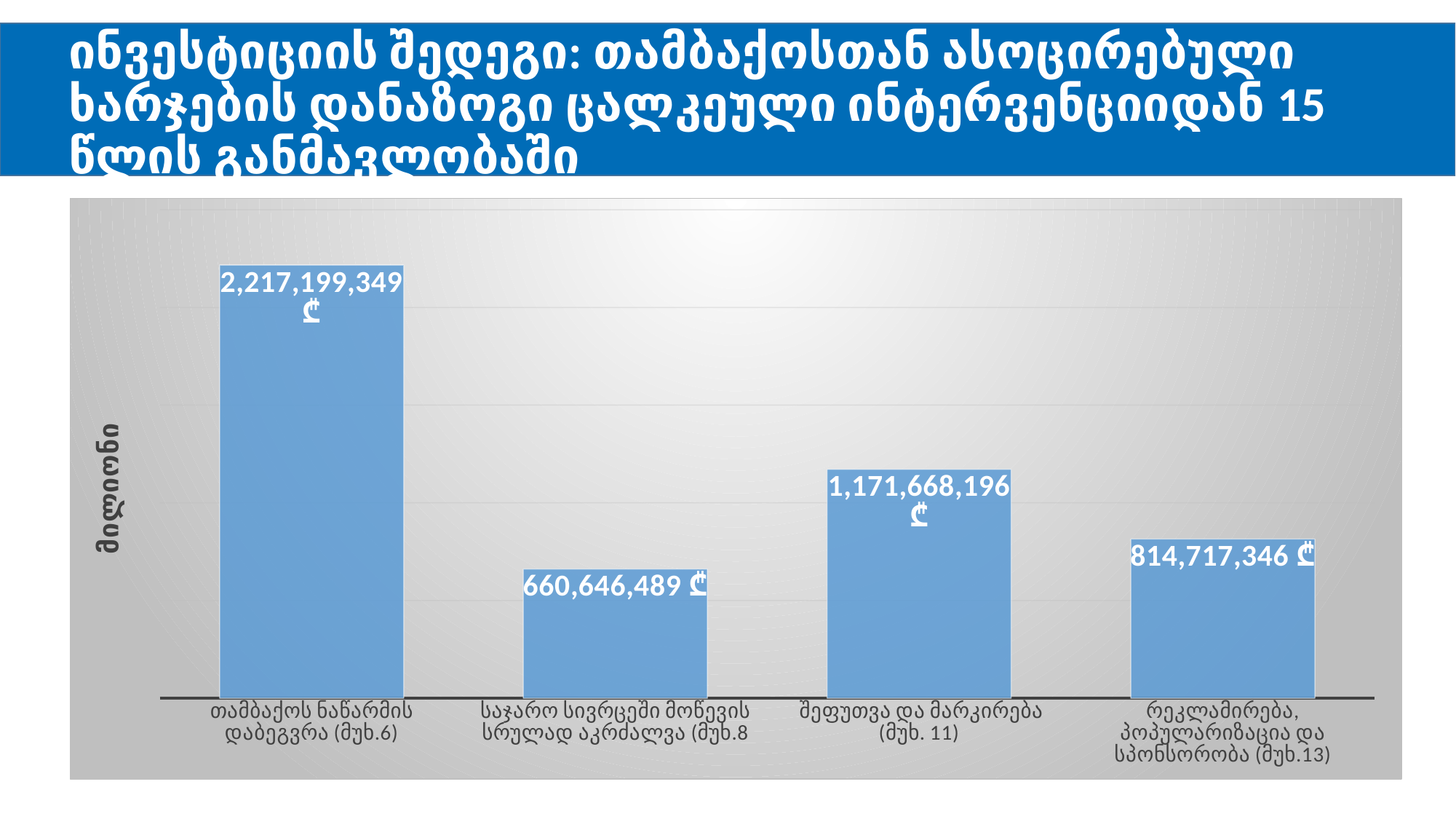
What is the value shown for საჯარო სივრცეში მოწევის სრულად აკრძალვა (მუხ.8)? 660,646,489 ₾ How many categories are shown in the chart? 4 What is the value shown for რეკლამირება, პოპულარიზაცია და სპონსორობა (მუხ.13)? 814,717,346 ₾ What is the difference between the values for შეფუთვა და მარკირება (მუხ. 11) and რეკლამირება, პოპულარიზაცია და სპონსორობა (მუხ.13)? 356,950,850 ₾ Which category has the lowest value? საჯარო სივრცეში მოწევის სრულად აკრძალვა (მუხ.8) What is the label on the vertical axis of the chart? მილიონი What is the value shown for თამბაქოს ნაწარმის დაბეგვრა (მუხ.6)? 2,217,199,349 ₾ What is the value shown for შეფუთვა და მარკირება (მუხ. 11)? 1,171,668,196 ₾ Which is larger: the value for შეფუთვა და მარკირება (მუხ. 11) or the value for რეკლამირება, პოპულარიზაცია და სპონსორობა (მუხ.13)? შეფუთვა და მარკირება (მუხ. 11) What is the difference between the values for თამბაქოს ნაწარმის დაბეგვრა (მუხ.6) and საჯარო სივრცეში მოწევის სრულად აკრძალვა (მუხ.8)? 1,556,552,860 ₾ Which category has the highest value? თამბაქოს ნაწარმის დაბეგვრა (მუხ.6) What kind of chart is shown on the slide? Bar chart